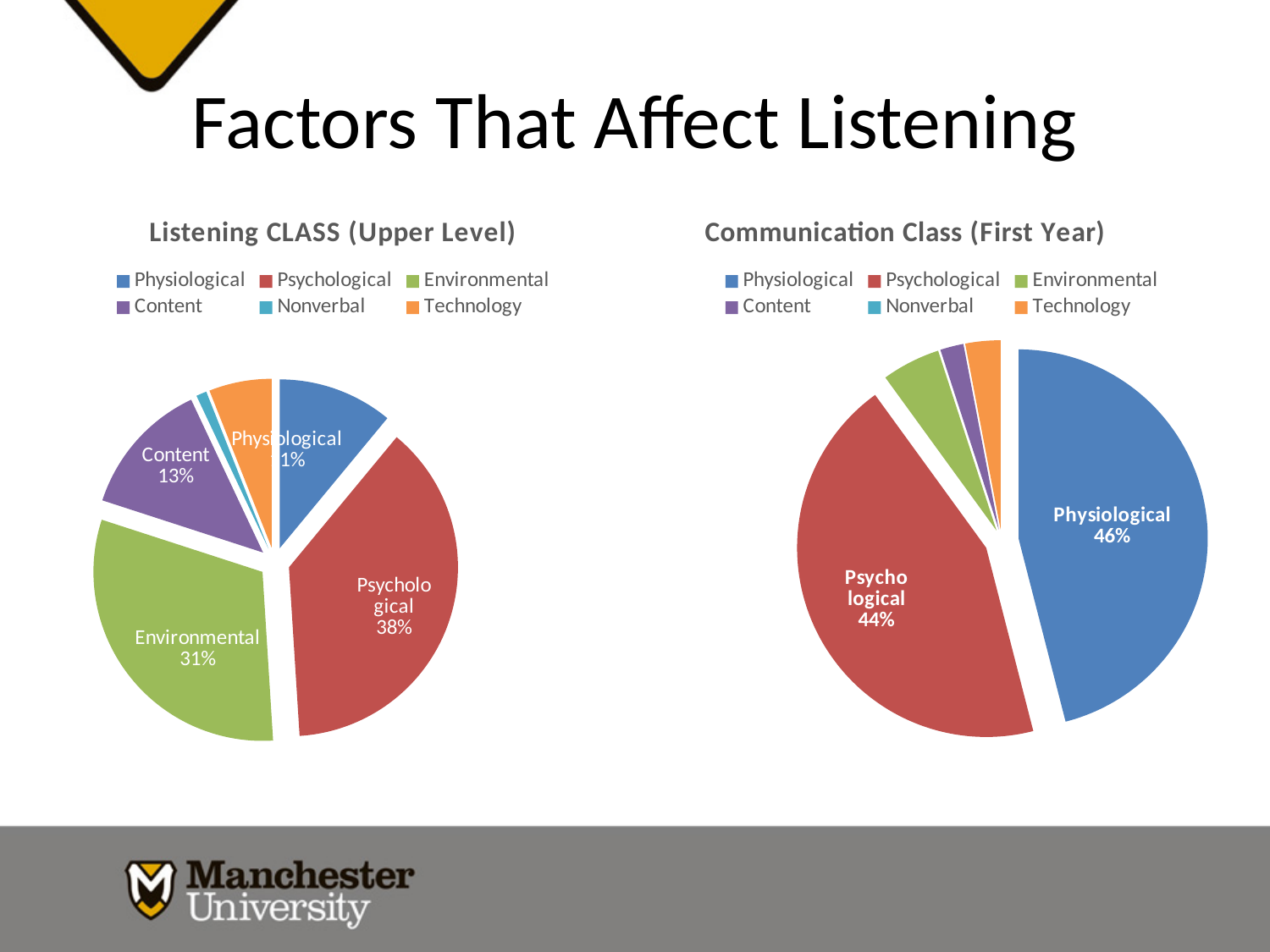
In the Listening CLASS (Upper Level) chart, what percentage is shown for Environmental? 31% In the Listening CLASS (Upper Level) chart, what percentage is shown for Content? 13% In the Listening CLASS (Upper Level) chart, which factor has the largest slice? Psychological What type of chart is used for the Listening CLASS (Upper Level) data? Pie chart In the Listening CLASS (Upper Level) chart, what percentage is shown for Psychological? 38% In the Communication Class (First Year) chart, what percentage is shown for Psychological? 44% In the Communication Class (First Year) chart, what percentage is shown for Physiological? 46% How many factors are listed in the legend of the Communication Class (First Year) chart? 6 In the Listening CLASS (Upper Level) chart, how many percentage points larger is Psychological than Environmental? 7 percentage points In the Listening CLASS (Upper Level) chart, which factor has the smallest slice? Nonverbal In the Communication Class (First Year) chart, which is larger, Physiological or Psychological? Physiological In the Communication Class (First Year) chart, what is the difference between Physiological and Psychological? 2 percentage points